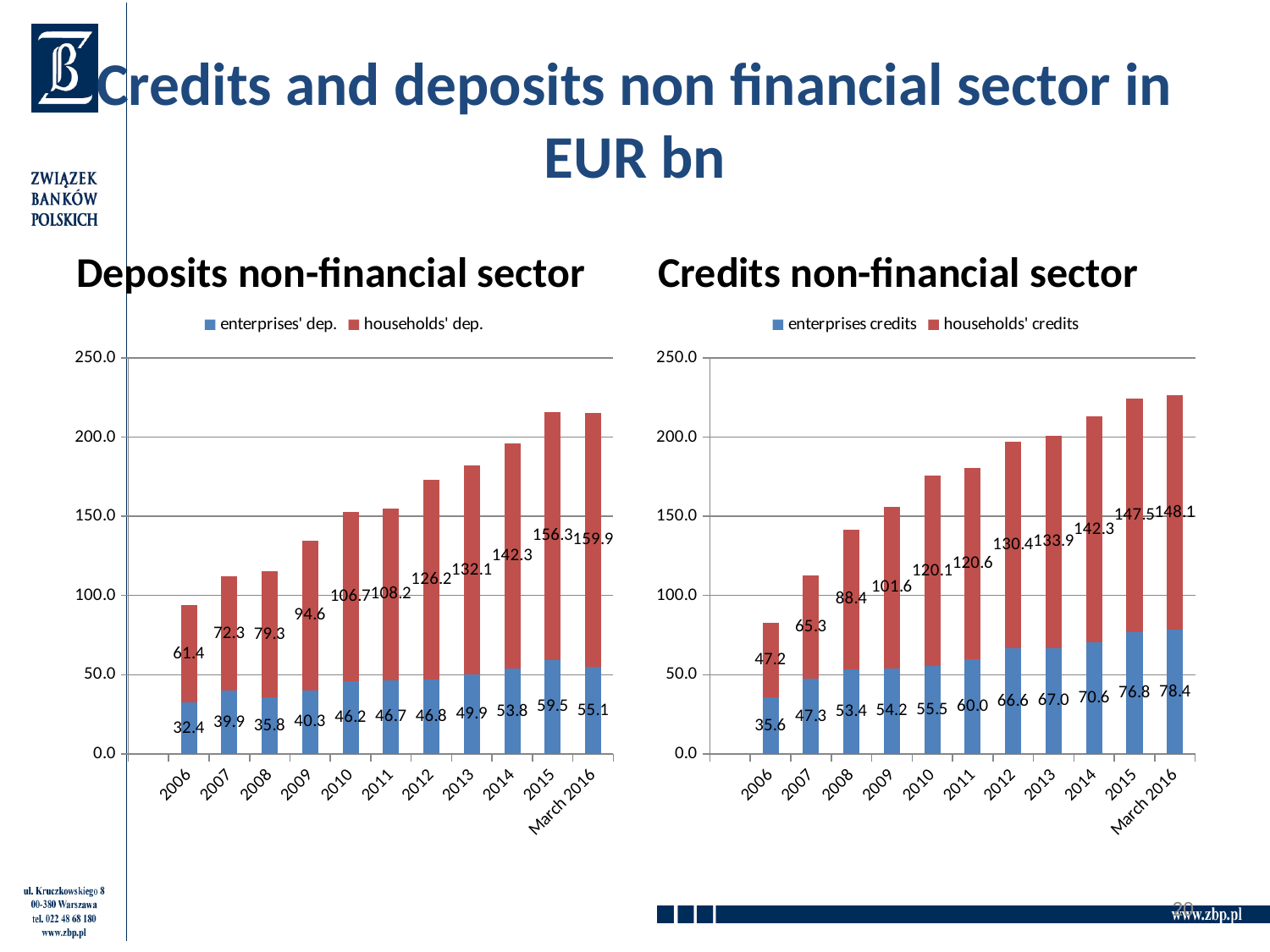
In the Credits non-financial sector chart, what is the total of the stacked bar for March 2016? 226.5 In the Deposits non-financial sector chart, which is larger: enterprises' deposits in 2015 or in March 2016? 2015 In the Deposits non-financial sector chart, what is the total of the stacked bar for 2015? 215.8 In the Credits non-financial sector chart, is the total stacked bar for 2014 greater or less than 200.0? greater In the Deposits non-financial sector chart, what is the value of households' deposits in 2015? 156.3 In the Deposits non-financial sector chart, what is the difference between households' deposits in 2015 and in 2006? 94.9 In the Credits non-financial sector chart, what is the value of enterprises credits in March 2016? 78.4 How many series does the legend of the Deposits non-financial sector chart list? 2 How many categories are shown on the x axis of the Credits non-financial sector chart? 11 In the Deposits non-financial sector chart, which year has the lowest enterprises' deposits? 2006 In the Credits non-financial sector chart, which category has the highest households' credits? March 2016 What kind of chart is the Credits non-financial sector chart? Stacked bar chart